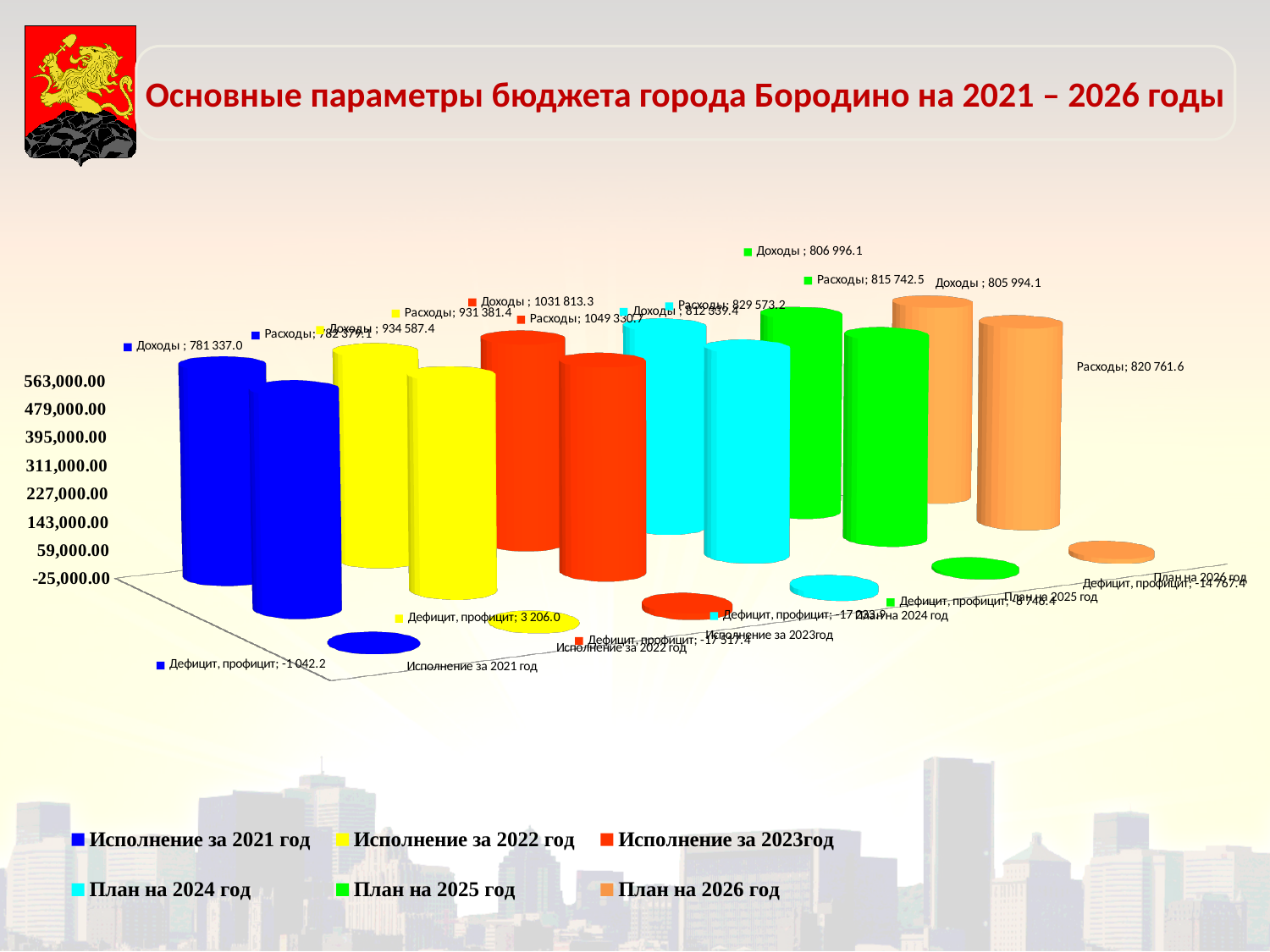
What is the value of Расходы for План на 2026 год? 820 761.6 What is the value of Расходы for Исполнение за 2023год? 1049 330.7 What colour represents План на 2024 год in the legend? cyan Which series has the highest value of Доходы? Исполнение за 2023год Which series has the lowest value of Доходы? Исполнение за 2021 год What is the difference between Расходы and Доходы for Исполнение за 2023год? 17 517.4 What is the value of Доходы for Исполнение за 2021 год? 781 337.0 What is the value of Дефицит, профицит for План на 2025 год? -8 746.4 What kind of chart is shown on the slide? bar chart How many series does the legend list? 6 What is the value of Дефицит, профицит for Исполнение за 2022 год? 3 206.0 For Исполнение за 2022 год, which is larger: Доходы or Расходы? Доходы